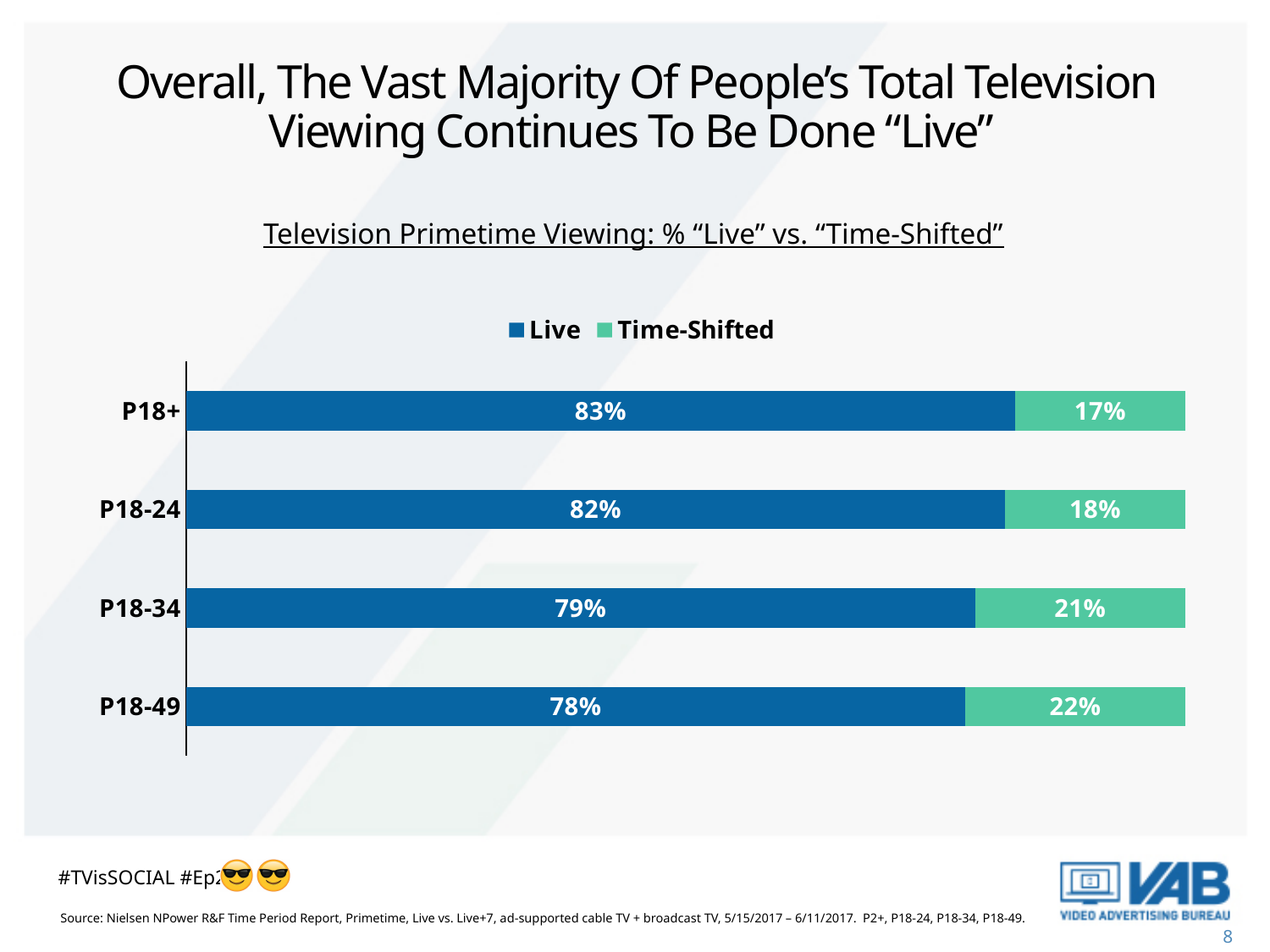
What is the Live value for P18+? 83% What is the Live value for P18-49? 78% What kind of chart is shown on the slide? Stacked bar chart Which is larger, the Time-Shifted value for P18-24 or for P18-34? P18-34 Which category has the lowest Live value? P18-49 Which category has the highest Time-Shifted value? P18-49 What is the difference between the Live values for P18+ and P18-49? 5% How many series does the legend list? 2 What is the total of the stacked bar for P18-24? 100% What is the Time-Shifted value for P18-34? 21% What is the title of the chart? Television Primetime Viewing: % "Live" vs. "Time-Shifted" How many categories are shown on the chart? 4